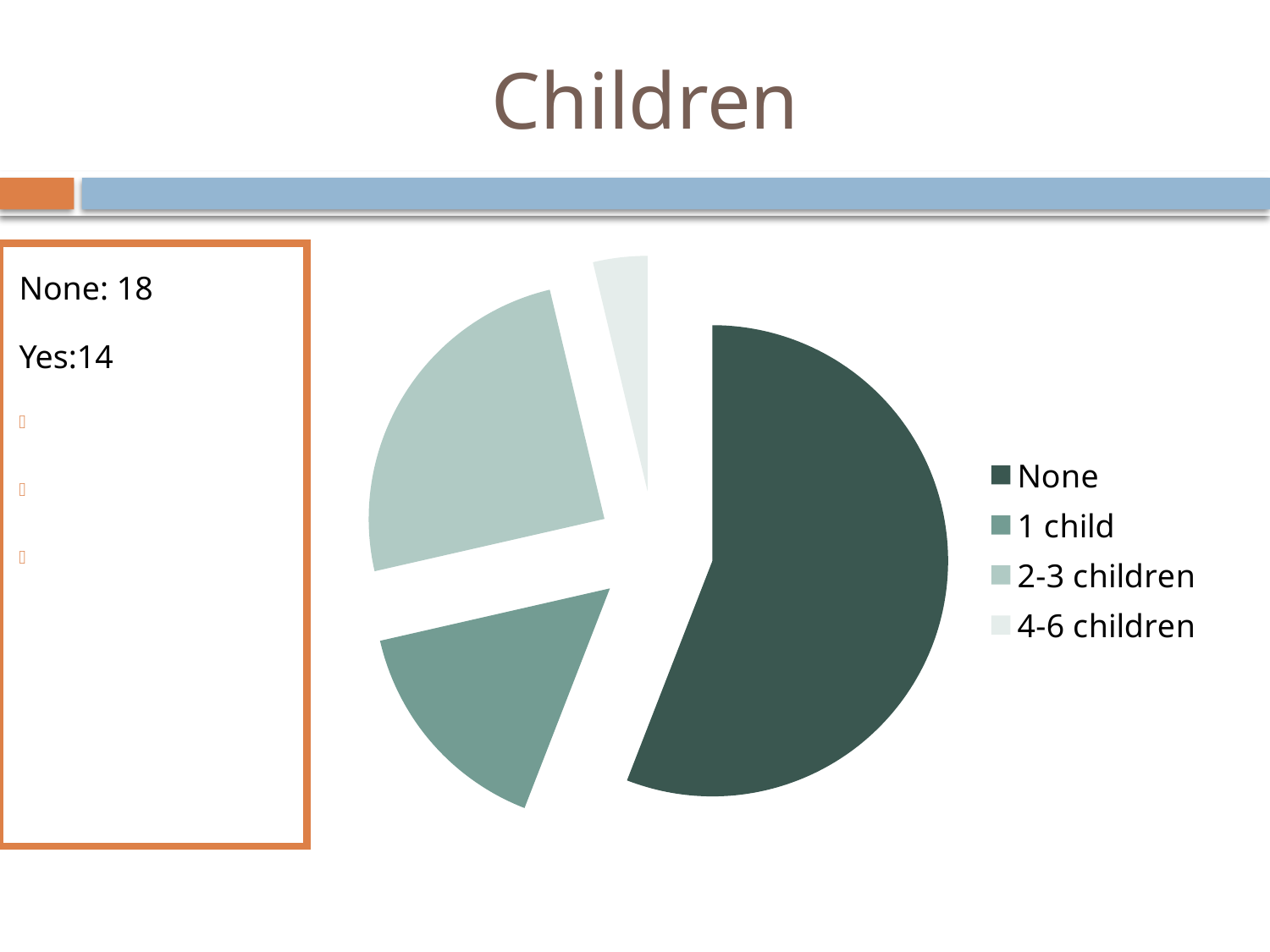
How many entries does the legend of the pie chart list? 4 What is the title of the slide containing the pie chart? Children Which category has the largest slice in the pie chart? None Which slice is larger in the pie chart, None or 2-3 children? None Which slice is larger in the pie chart, 1 child or 4-6 children? 1 child What kind of chart is shown on the slide? pie chart Which legend entry is shown in the darkest green colour in the pie chart? None Which slice is larger in the pie chart, 2-3 children or 1 child? 2-3 children How many slices does the pie chart have? 4 Which category has the smallest slice in the pie chart? 4-6 children Which legend entry is listed last in the pie chart's legend? 4-6 children